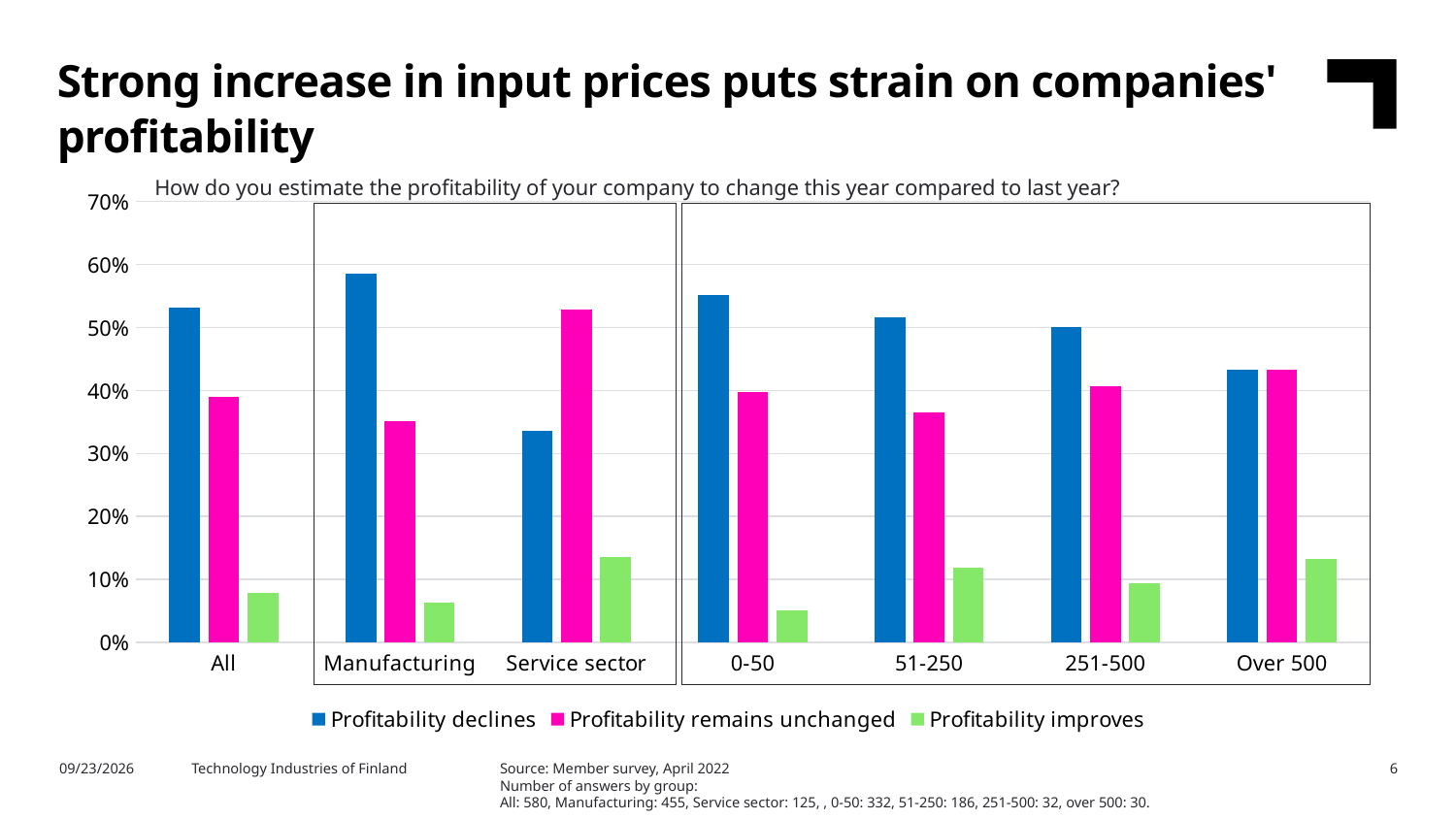
Is the value for "Profitability declines" in Manufacturing greater or less than 50%? greater Is the value for "Profitability declines" in the Service sector greater or less than 40%? less What colour represents "Profitability improves" in the chart? green Which category has the highest value for "Profitability declines"? Manufacturing Which category has the lowest value for "Profitability declines"? Service sector How many series does the legend list? 3 In the Service sector, which is larger: "Profitability declines" or "Profitability remains unchanged"? Profitability remains unchanged Is the value for "Profitability improves" in the 51-250 group greater or less than 10%? greater How many categories are shown along the x axis? 7 Which category has the highest value for "Profitability remains unchanged"? Service sector What kind of chart is shown on the slide? bar chart